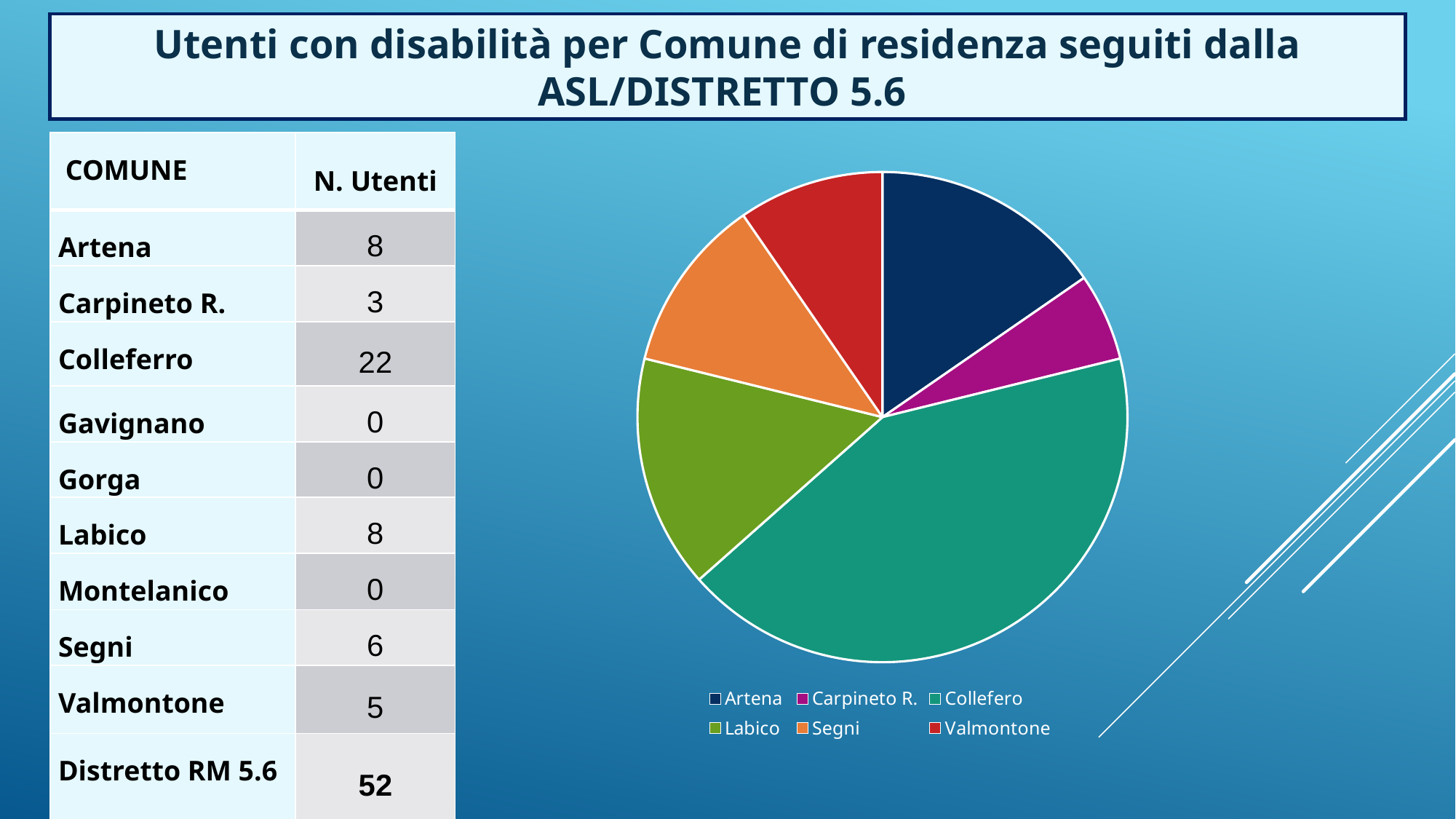
What colour is the Collefero slice in the pie chart? teal (green-blue) What is the difference in users between Colleferro and Artena according to the table? 14 Is the slice for Artena larger or smaller than the slice for Valmontone? larger According to the table, how many users (N. Utenti) does Colleferro have? 22 How many slices does the pie chart have? 6 Is the slice for Collefero larger or smaller than the slice for Labico? larger According to the table, how many users does Segni have? 6 What kind of chart is shown on the slide? pie chart Which comune has the largest slice in the pie chart? Collefero How many entries does the pie chart's legend list? 6 What is the total number of users for Distretto RM 5.6 shown in the table? 52 Which comune has the smallest slice in the pie chart? Carpineto R.